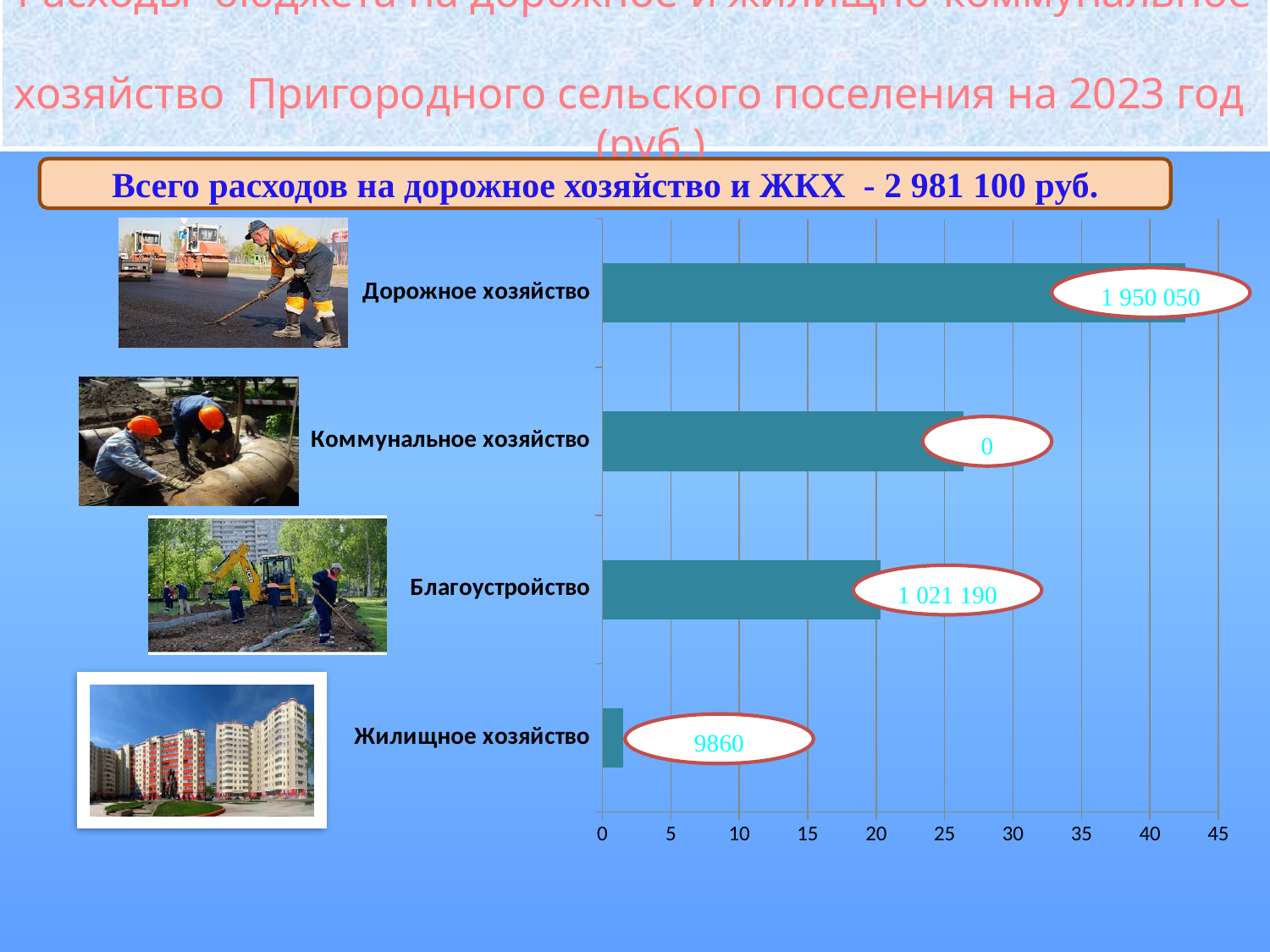
What value is labelled for Благоустройство? 1 021 190 Is the bar for Дорожное хозяйство greater or less than 40 on the axis? greater Which category has the shortest bar in the chart? Жилищное хозяйство Is the bar for Жилищное хозяйство greater or less than 5 on the axis? less What value is labelled for Жилищное хозяйство? 9860 Which bar is longer, Дорожное хозяйство or Благоустройство? Дорожное хозяйство Which category has the longest bar in the chart? Дорожное хозяйство How many categories does the chart show? 4 What is the difference between the labelled values for Дорожное хозяйство and Благоустройство? 928 860 What value is labelled for Дорожное хозяйство? 1 950 050 What kind of chart is shown on the slide? bar chart What total expenditure on road management and housing and utilities is stated in the banner above the chart? 2 981 100 руб.